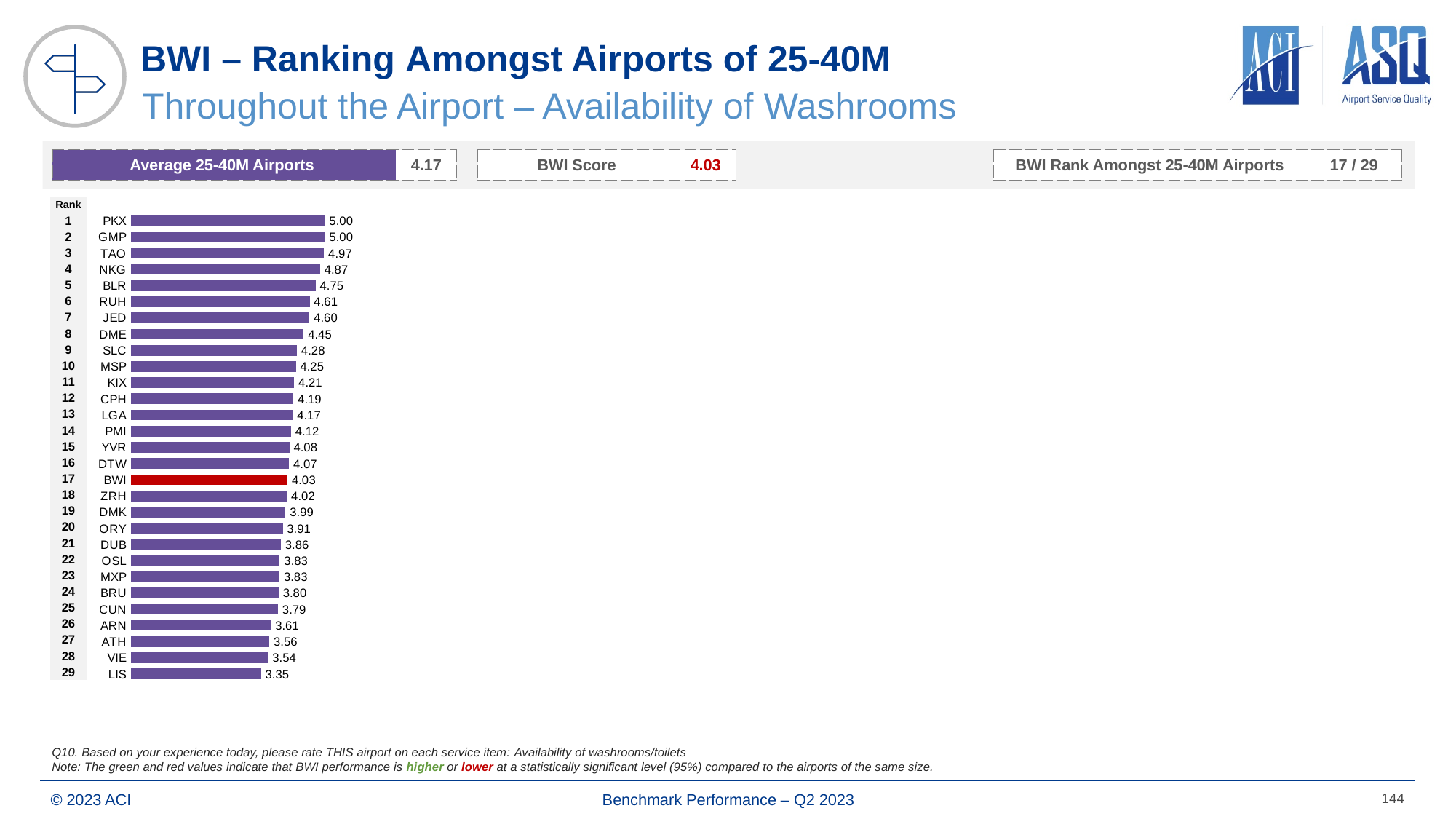
What is the value for TAO? 4.97 Do the values rise or fall going down the ranking from rank 1 to rank 29? fall What kind of chart is shown on the slide? bar chart What is the difference between the values for PKX and LIS? 1.65 How many airports are ranked in the chart? 29 What is the value for BWI? 4.03 Which is larger, the value for MSP or the value for ORY? MSP What is the value for DUB? 3.86 Which airport has the lowest value? LIS What is the difference between the values for BWI and ZRH? 0.01 What rank does BWI hold amongst 25-40M airports? 17 / 29 Which bar in the chart is coloured red? BWI